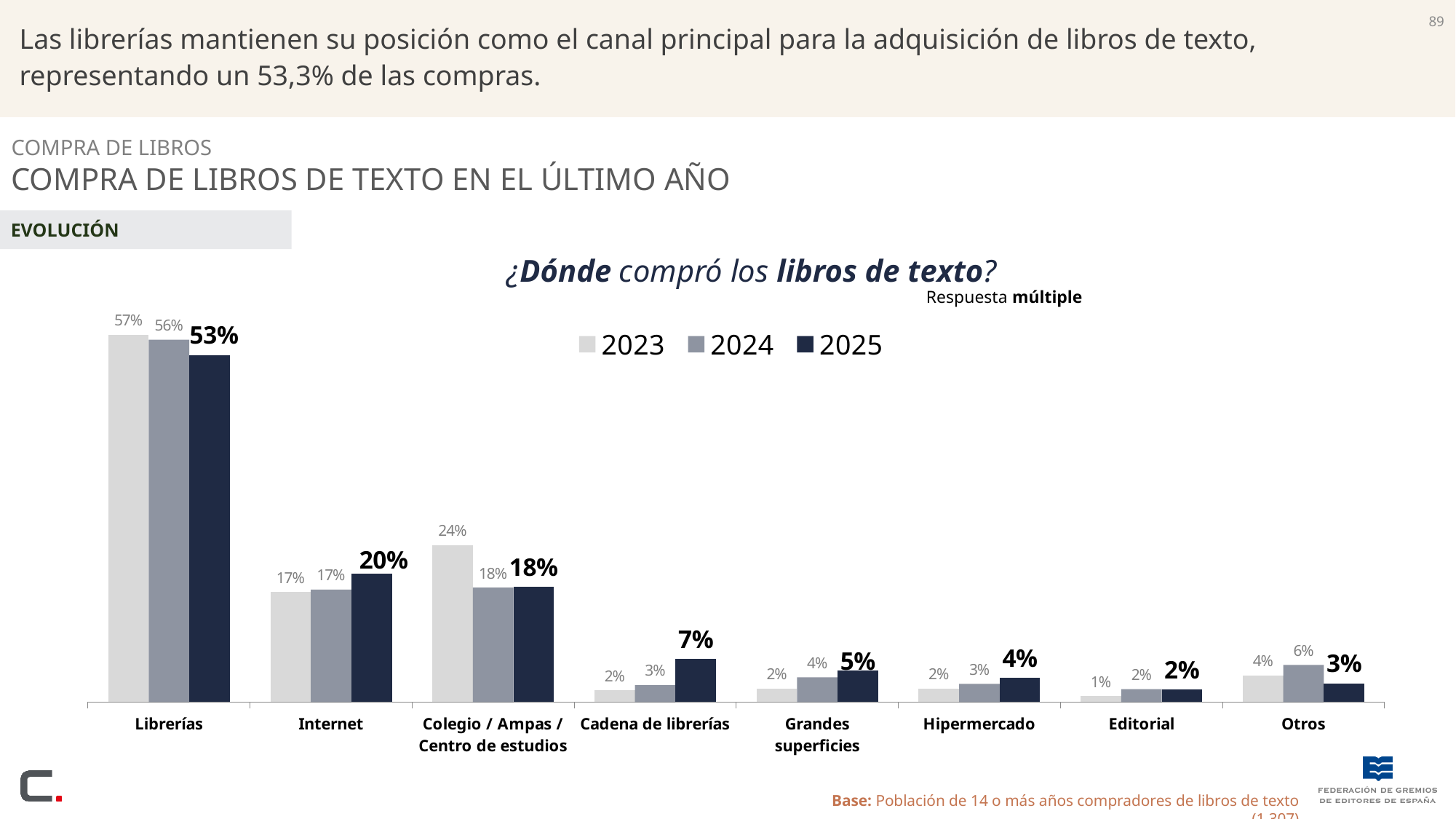
What question is the chart titled with? ¿Dónde compró los libros de texto? What is the value for Librerías in 2025? 53% How many series does the legend list? 3 What is the difference between the 2023 and 2025 values for Librerías? 4% How many categories are shown on the x axis? 8 Which category has the lowest value in 2023? Editorial Which category has the highest value in 2025? Librerías Which is larger in 2025: Internet or Colegio / Ampas / Centro de estudios? Internet Did the value for Cadena de librerías rise or fall from 2023 to 2025? Rise What kind of chart is shown on the slide? Bar chart What is the value for Otros in 2024? 6% What is the value for Colegio / Ampas / Centro de estudios in 2023? 24%